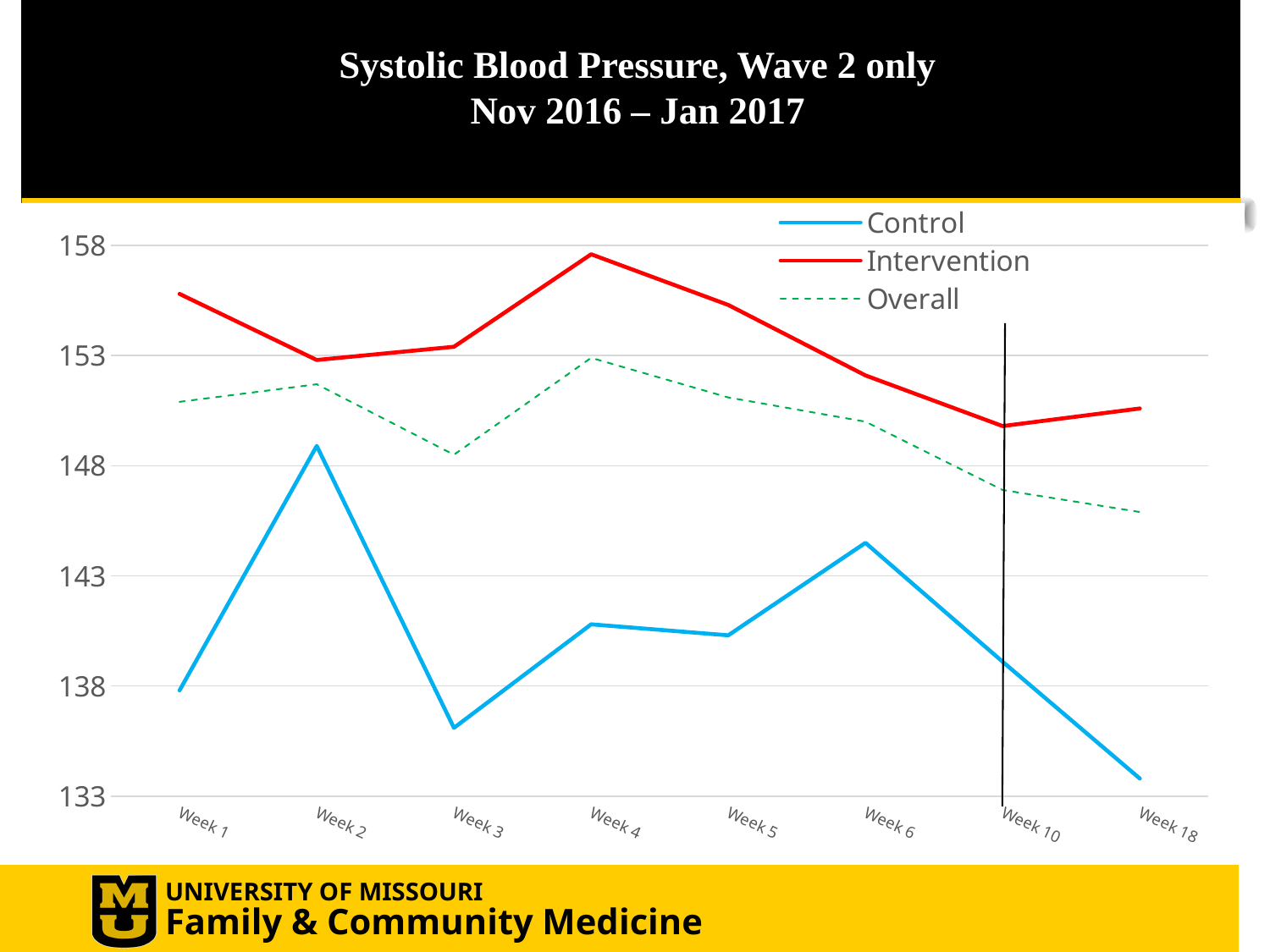
How many series does the legend list? 3 Which series is drawn with a dashed line? Overall At which week does the Control series reach its highest value? Week 2 What kind of chart is shown on the slide? Line chart How many weeks are plotted along the x axis? 8 At Week 4, which series has the higher value, Intervention or Control? Intervention Does the Intervention series rise or fall from Week 4 to Week 10? Fall Is the Overall value at Week 18 greater or less than 148? less At which week does the Intervention series reach its highest value? Week 4 Is the Control value at Week 3 greater or less than 138? less Is the Intervention value at Week 10 greater or less than 153? less At which week does the Control series reach its lowest value? Week 18